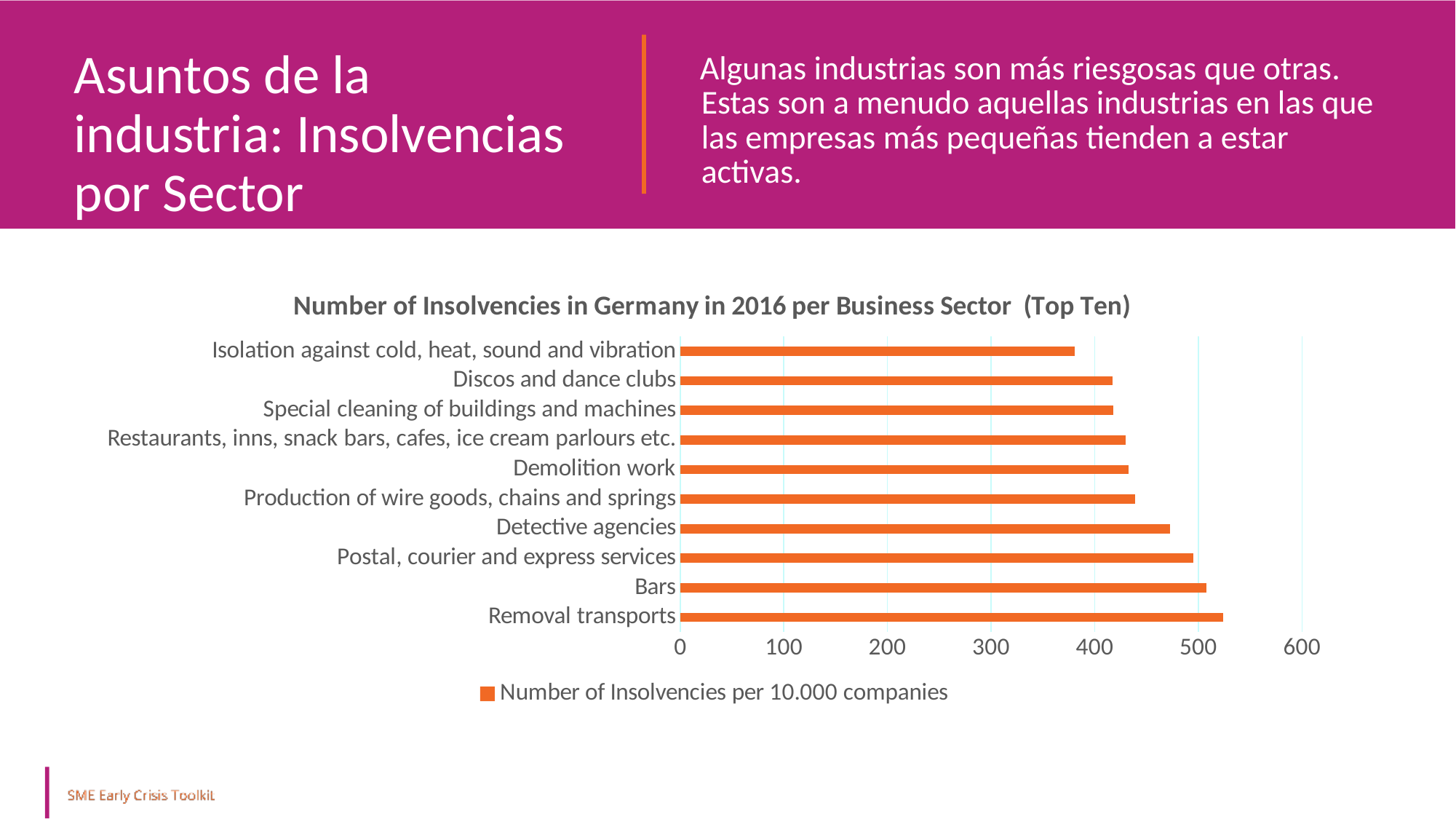
Is the value for Removal transports greater or less than 500? greater Which has more insolvencies per 10.000 companies: Detective agencies or Demolition work? Detective agencies Which business sector has the highest number of insolvencies per 10.000 companies? Removal transports What kind of chart is shown on the slide? bar chart What is the title of the chart? Number of Insolvencies in Germany in 2016 per Business Sector (Top Ten) What is the legend entry for the series in the chart? Number of Insolvencies per 10.000 companies Is the value for Isolation against cold, heat, sound and vibration greater or less than 400? less Is the value for Detective agencies greater or less than 500? less How many business sectors are plotted in the chart? 10 Which has more insolvencies per 10.000 companies: Postal, courier and express services or Production of wire goods, chains and springs? Postal, courier and express services Which business sector has the lowest number of insolvencies per 10.000 companies? Isolation against cold, heat, sound and vibration How many series does the legend list? 1